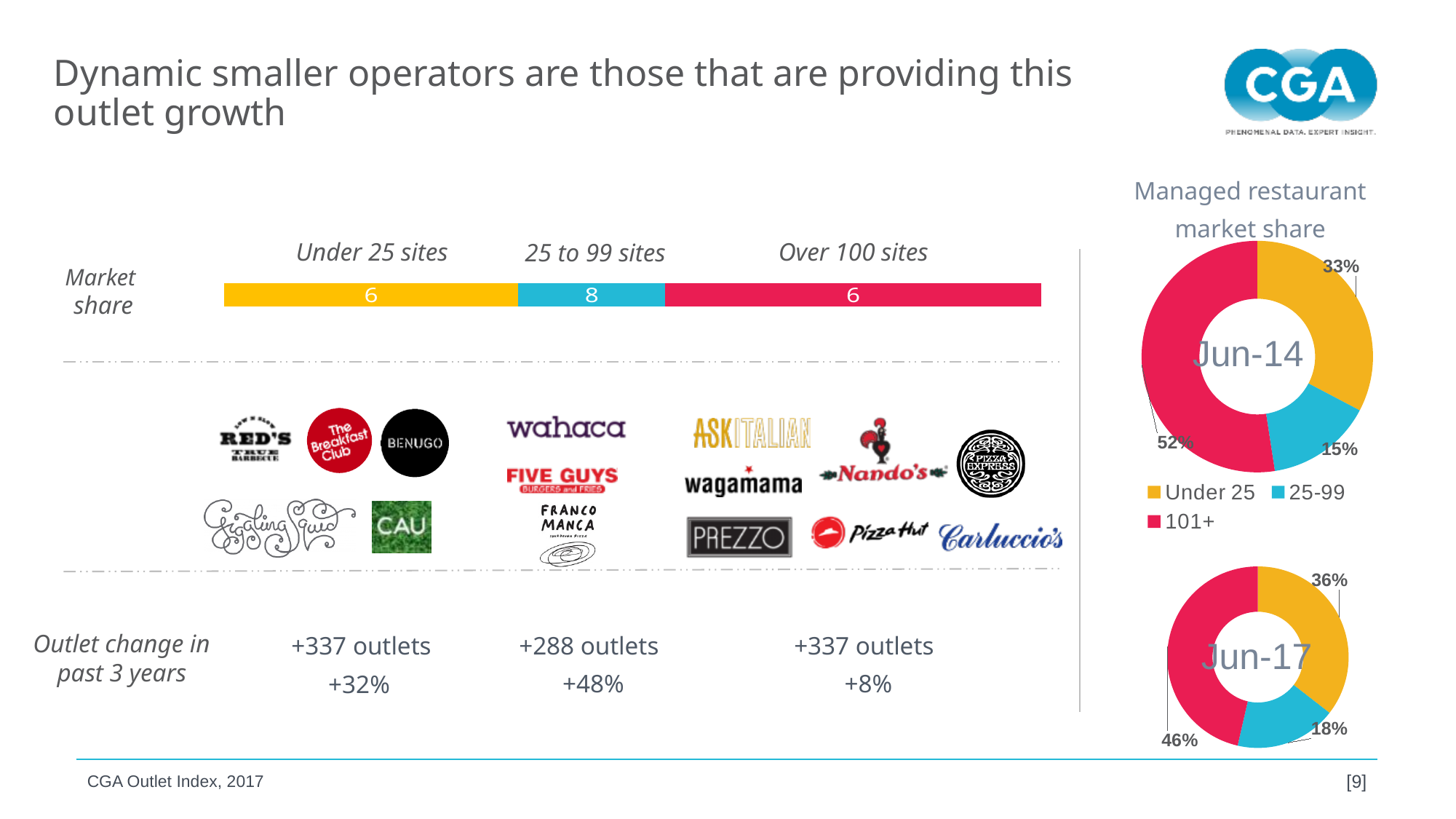
Did the 101+ share rise or fall from the Jun-14 donut chart to the Jun-17 donut chart? Fall In the Jun-17 donut chart, what is the difference between the Under 25 share and the 25-99 share? 18% In the Jun-17 donut chart, what is the market share for 25-99? 18% In the Jun-14 donut chart, which category has the smallest share? 25-99 In the Market share stacked bar at the top of the slide, what is the total of the three segments? 20 What kind of chart is used to show the managed restaurant market share for Jun-14 and Jun-17? Donut (pie) chart In the Market share stacked bar at the top of the slide, what is the value for 25 to 99 sites? 8 In the Jun-14 donut chart, what is the market share for 101+? 52% In the Jun-17 donut chart, what is the market share for Under 25? 36% How many categories does the legend of the market share donut charts list? 3 In the Jun-17 donut chart, which category has the largest share? 101+ In the Jun-14 donut chart, which is larger: the Under 25 share or the 25-99 share? Under 25